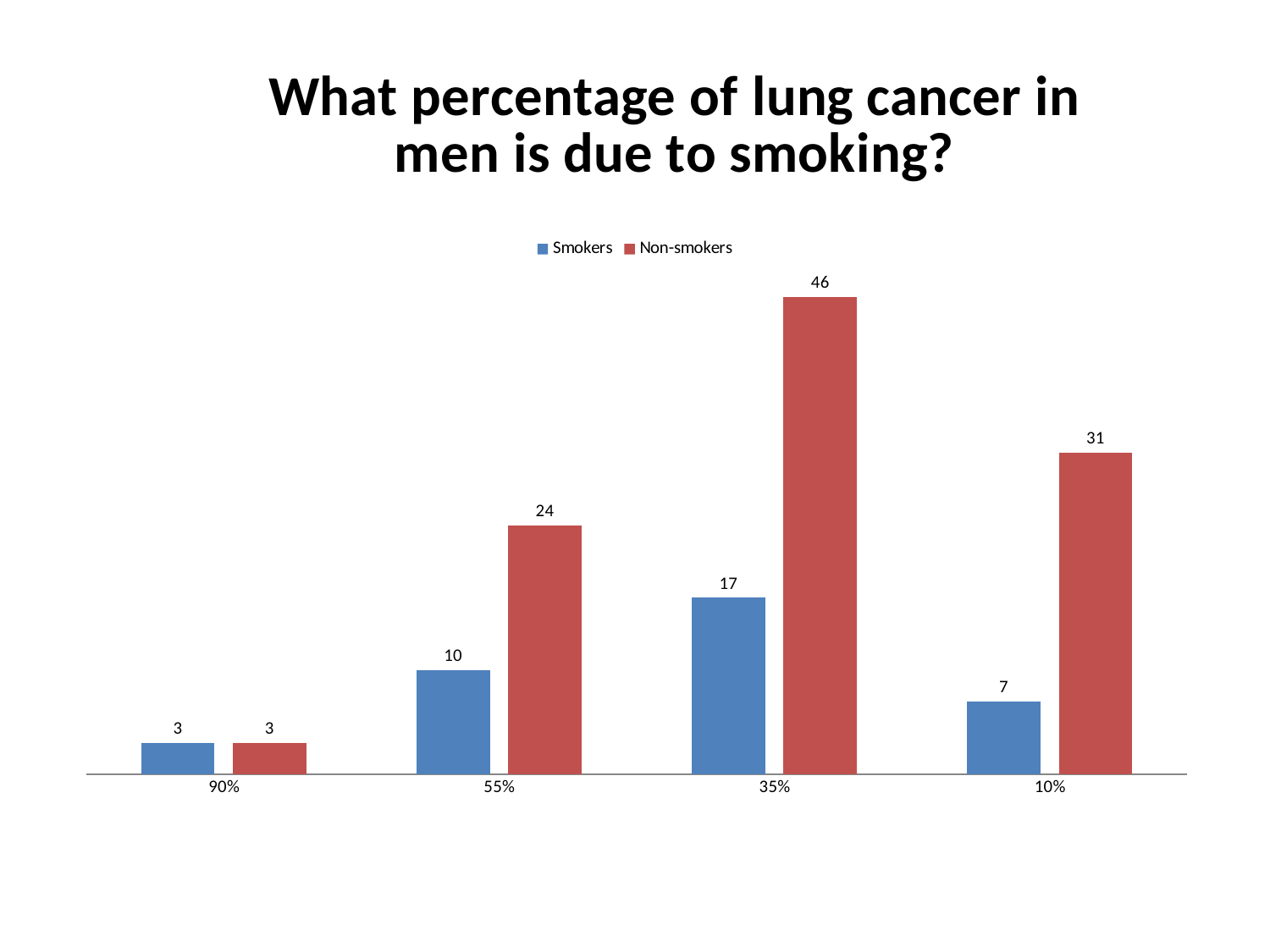
Which is larger: the Smokers value for 35% or the Smokers value for 10%? 35% Which category has the lowest Smokers value? 90% What is the value for Smokers in the 55% category? 10 What is the difference between the Non-smokers and Smokers values in the 35% category? 29 What is the title of the slide? What percentage of lung cancer in men is due to smoking? How many series does the legend list? 2 How many categories are shown on the x axis? 4 What is the value for Non-smokers in the 35% category? 46 What is the value for Non-smokers in the 10% category? 31 Which colour represents Non-smokers in the chart? Red What kind of chart is shown on the slide? Bar chart Which category has the highest Non-smokers value? 35%